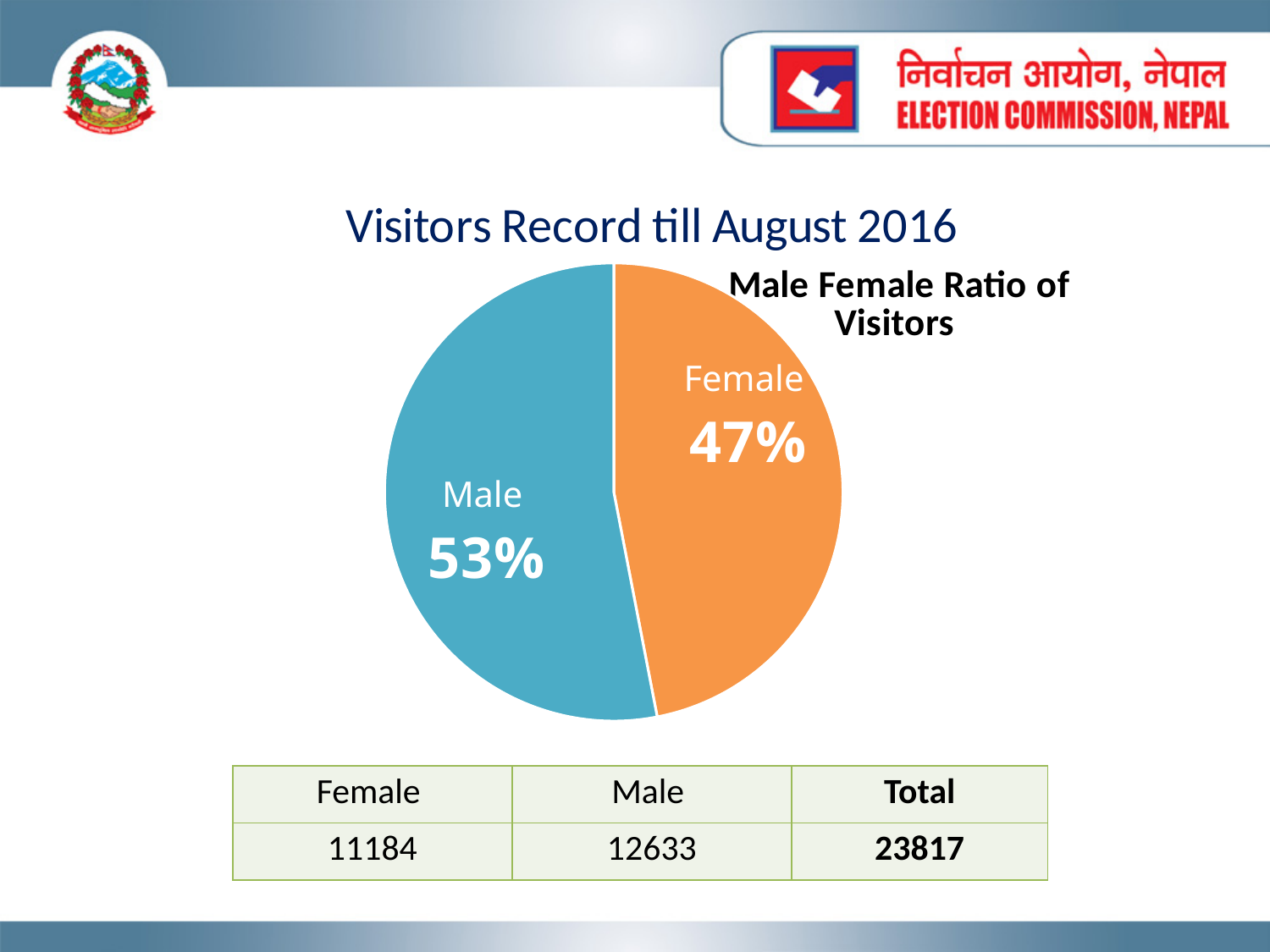
Which slice of the pie chart is the smallest? Female What percentage of visitors are Male according to the pie chart? 53% Is the Male share of visitors larger or smaller than the Female share? larger How many slices does the pie chart have? 2 Is the Female share of visitors greater or less than 50%? less What kind of chart is shown on the slide? pie chart What percentage of visitors are Female according to the pie chart? 47% What is the title of the chart? Visitors Record till August 2016 Which slice of the pie chart is the largest? Male What is the share of the pie represented by the Female slice? 47% What is the difference in percentage points between the Male and Female shares? 6% What colour is the Male slice of the pie chart? blue